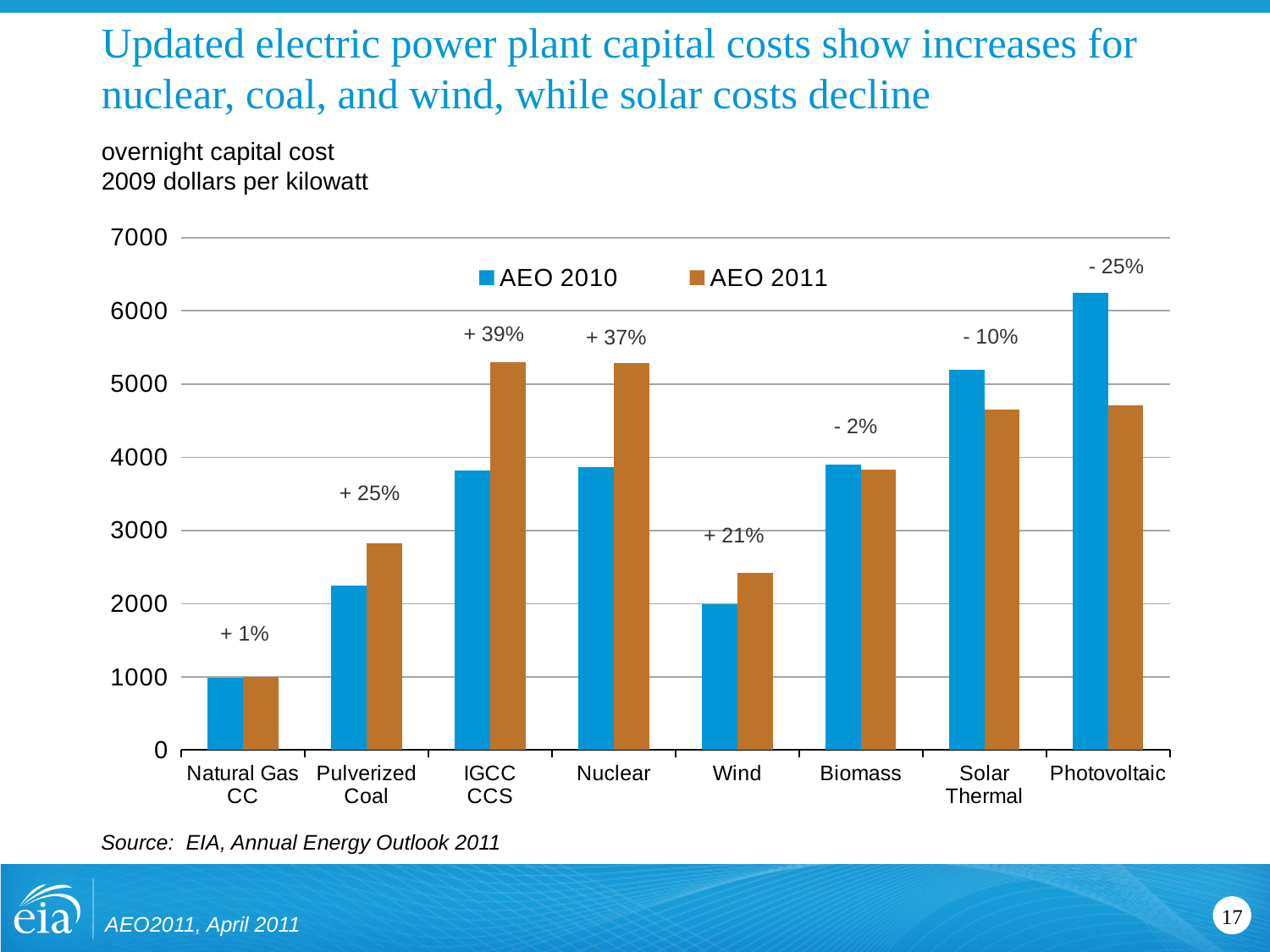
Which plant type shows the largest percentage increase in capital cost? IGCC CCS Is the AEO 2010 value for Wind greater or less than 3000? less Which plant type has the highest AEO 2010 overnight capital cost? Photovoltaic For Solar Thermal, which series has the larger value, AEO 2010 or AEO 2011? AEO 2010 Is the AEO 2010 value for Photovoltaic greater or less than 6000? greater How many series does the legend list? 2 What percentage change is labelled above the Photovoltaic bars? - 25% What percentage change is labelled above the IGCC CCS bars? + 39% How many plant types (categories) are shown on the x axis? 8 What percentage change is labelled above the Wind bars? + 21% Which plant type has the lowest AEO 2011 overnight capital cost? Natural Gas CC What kind of chart is shown on the slide? bar chart